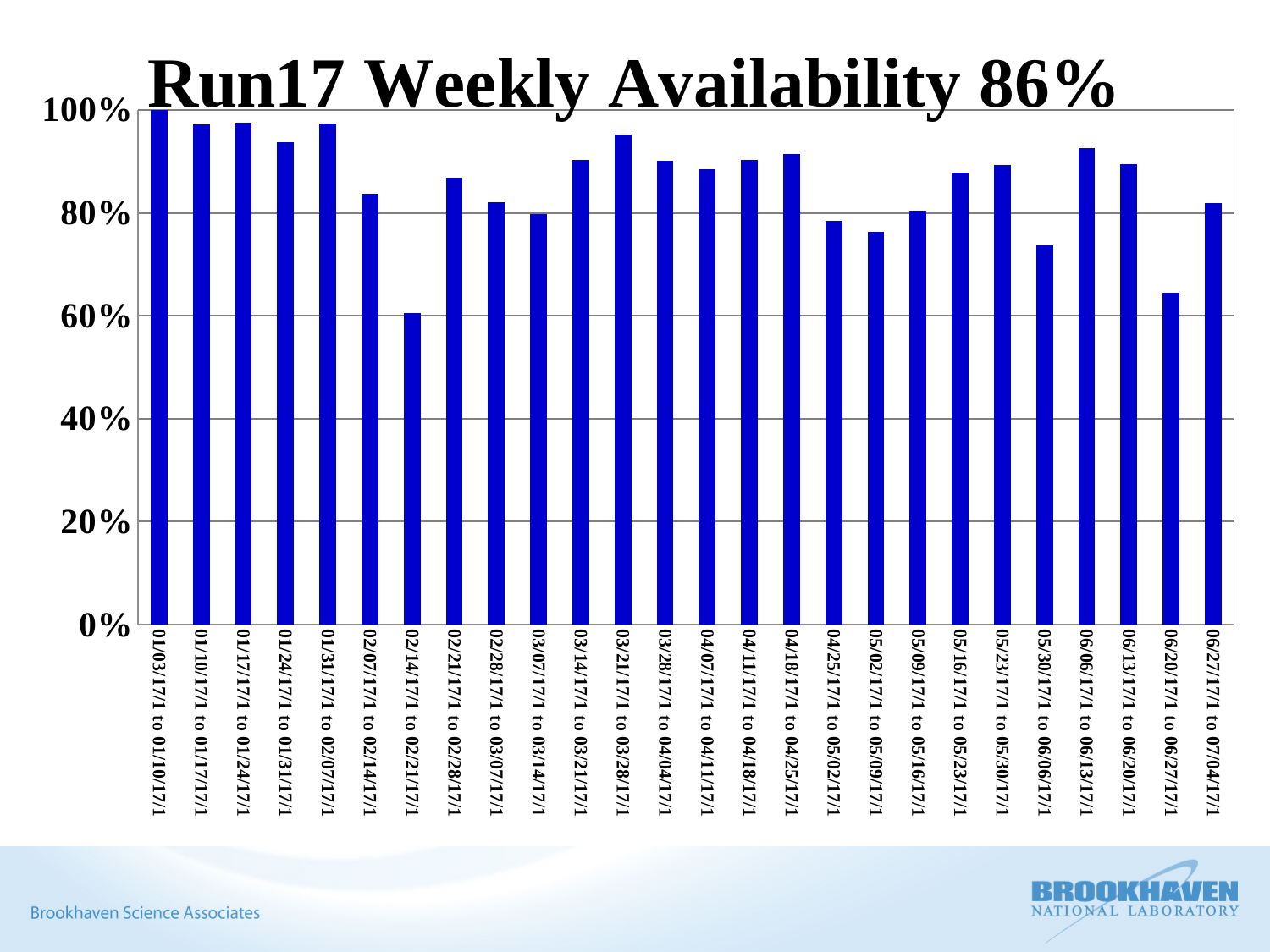
What colour are the bars in the chart? blue Which week has the lowest availability? 02/14/17/1 to 02/21/17/1 How many weekly bars are plotted in the chart? 26 Which week has the highest availability? 01/03/17/1 to 01/10/17/1 Which is larger, the value for 06/20/17/1 to 06/27/17/1 or the value for 06/27/17/1 to 07/04/17/1? 06/27/17/1 to 07/04/17/1 Which is larger, the value for 03/21/17/1 to 03/28/17/1 or the value for 05/30/17/1 to 06/06/17/1? 03/21/17/1 to 03/28/17/1 What is the title of the chart? Run17 Weekly Availability 86% Is the value for 06/20/17/1 to 06/27/17/1 greater or less than 60%? greater Is the value for 06/20/17/1 to 06/27/17/1 greater or less than 80%? less Is the value for 05/30/17/1 to 06/06/17/1 greater or less than 80%? less What kind of chart is shown on the slide? bar chart